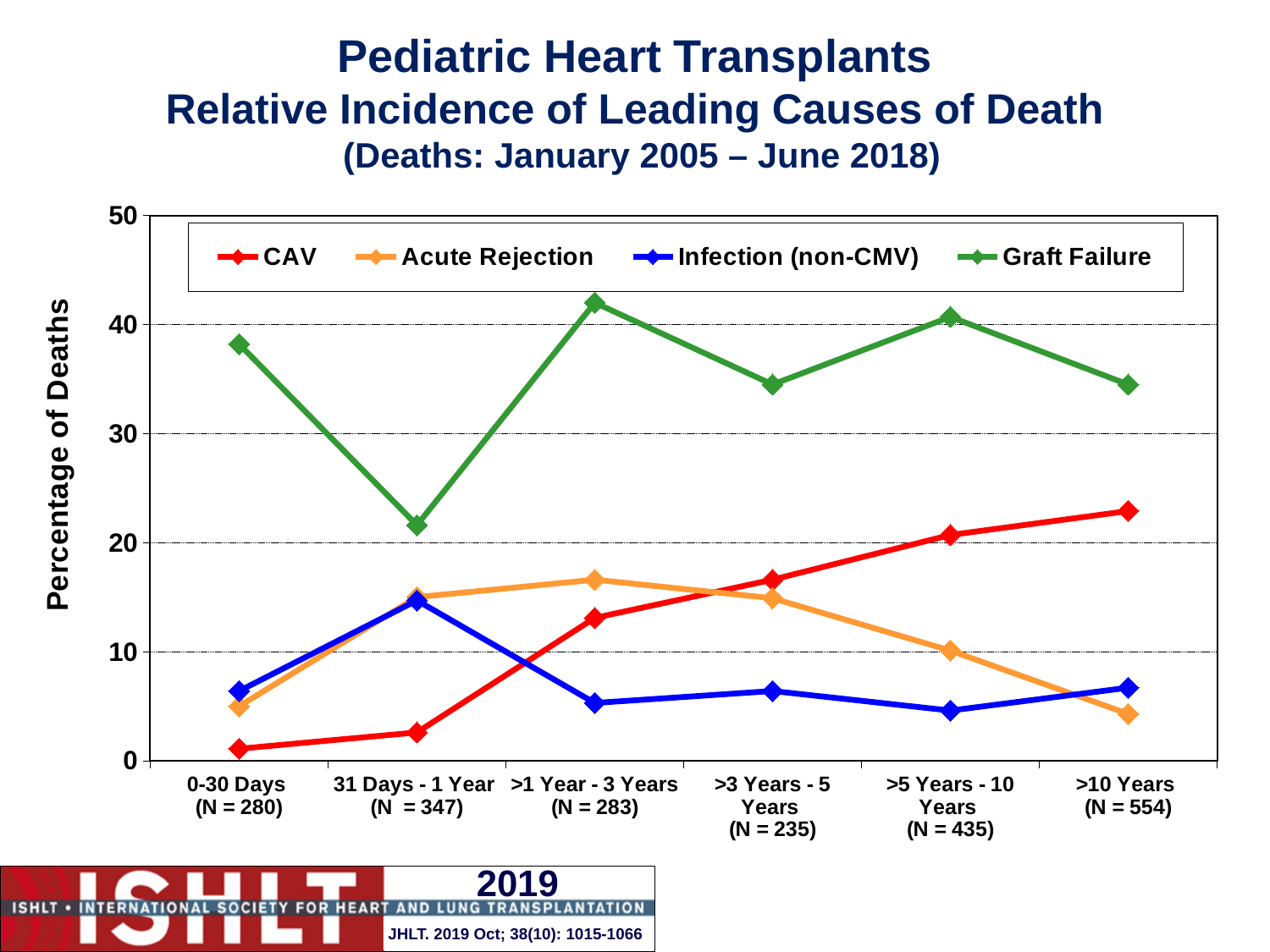
Does the CAV line rise or fall from 0-30 Days to >10 Years? rise How many time-period categories are shown on the x axis? 6 What is the label of the y axis? Percentage of Deaths Is the Graft Failure value for 0-30 Days greater or less than 30? greater How many series does the legend list? 4 At 0-30 Days, which is larger: Graft Failure or CAV? Graft Failure Is the CAV value for >10 Years greater or less than 20? greater In which time period is the CAV value lowest? 0-30 Days In which time period is the Graft Failure value lowest? 31 Days - 1 Year Is the Acute Rejection value for >10 Years greater or less than 10? less What kind of chart is shown on the slide? line chart In which time period is the CAV value highest? >10 Years